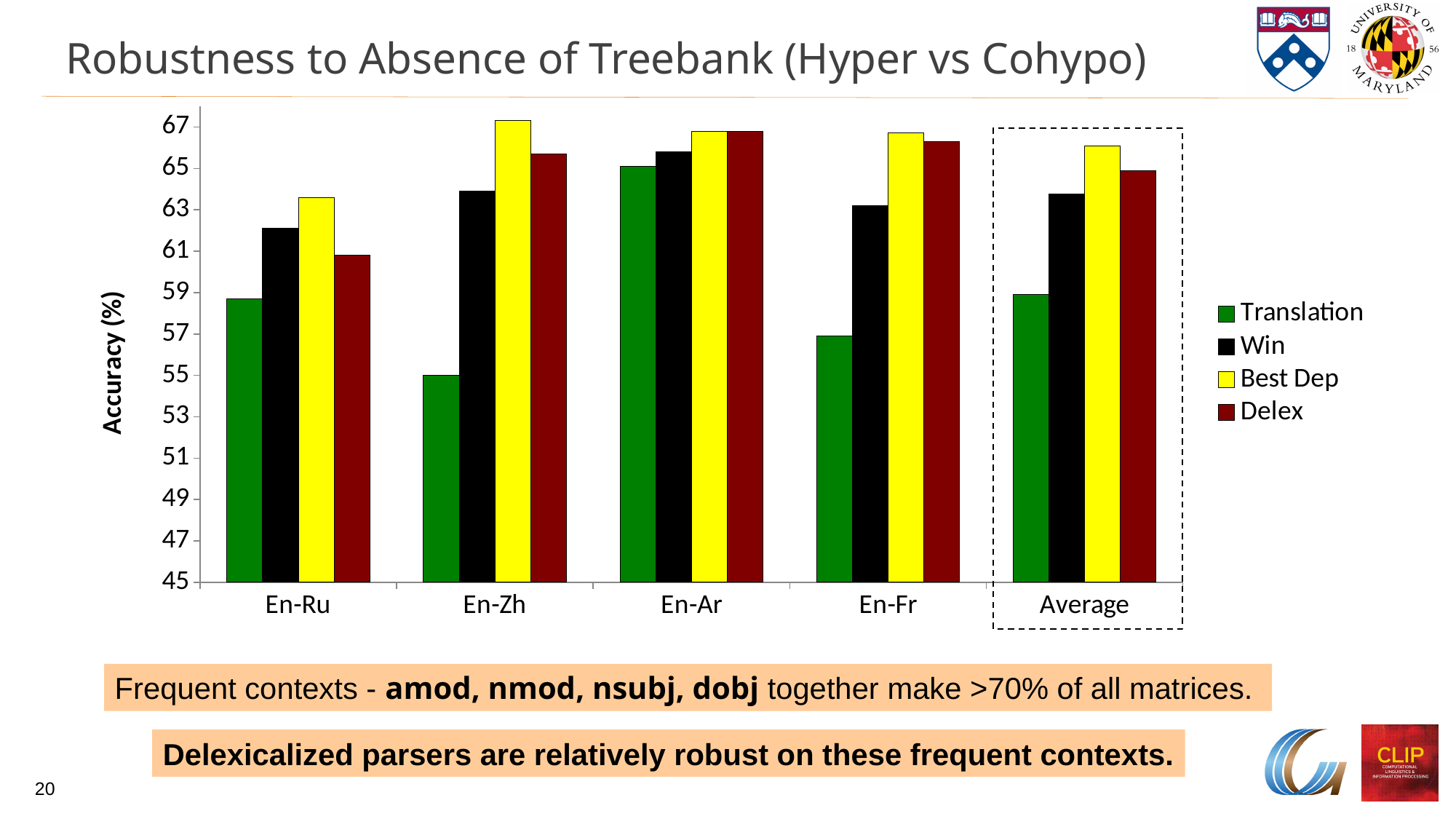
Which category has the lowest Translation value? En-Zh Is the Translation value for En-Zh greater or less than 57? less Which is larger, the Translation value for En-Ar or the Translation value for En-Fr? En-Ar What is the label of the y axis? Accuracy (%) Which series has the highest value for En-Ru? Best Dep Is the Win value for Average greater or less than 63? greater What kind of chart is shown on the slide? bar chart How many series does the legend list? 4 Which series has the lowest value for En-Zh? Translation How many categories are shown along the x axis? 5 Is the Delex value for En-Ru greater or less than 63? less